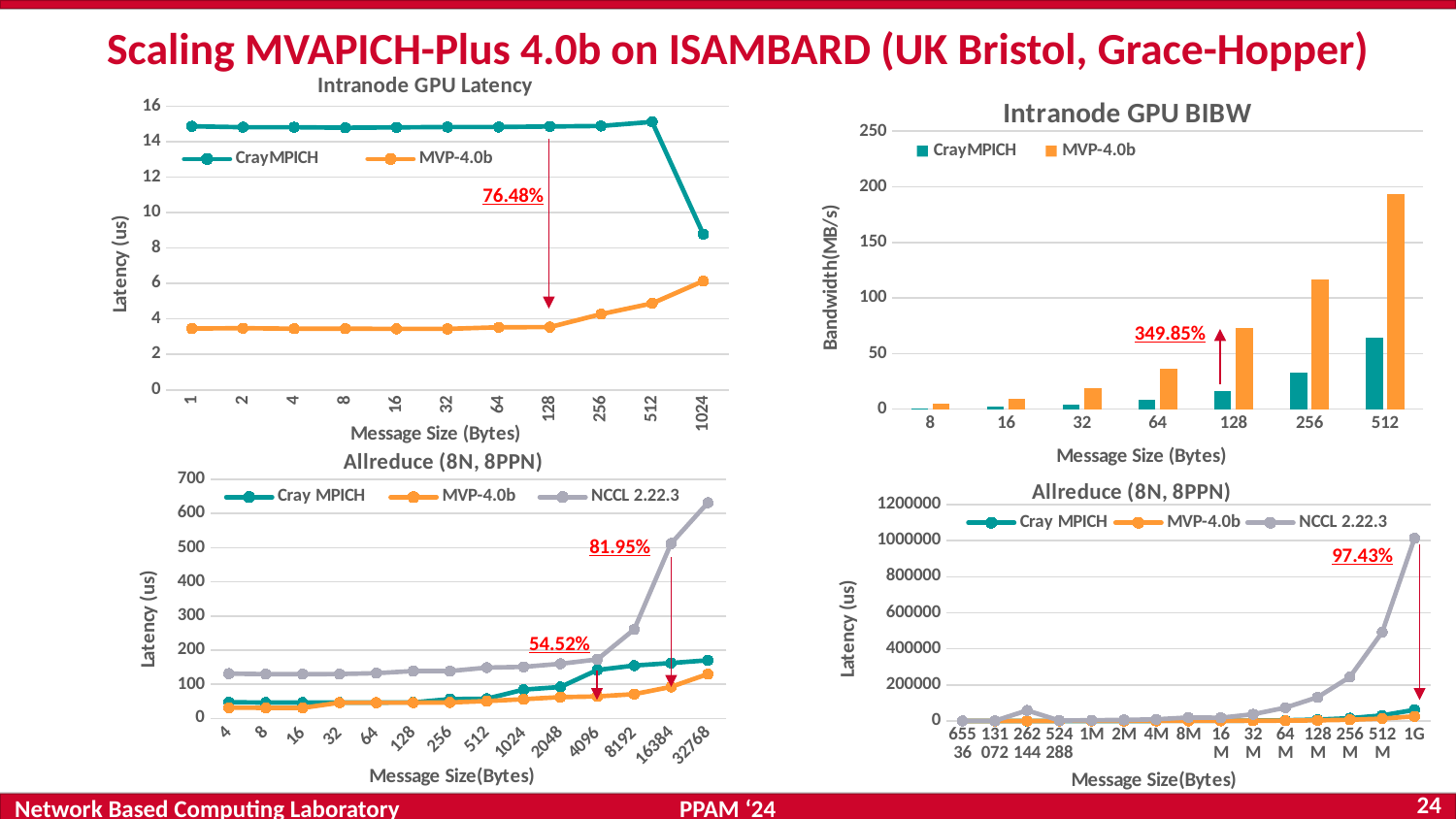
What kind of chart is the top-left 'Intranode GPU Latency' chart? line chart In the 'Intranode GPU Latency' chart, how many series does the legend list? 2 In the 'Intranode GPU Latency' chart, how many message sizes are shown on the x axis? 11 What kind of chart is the 'Intranode GPU BIBW' chart? bar chart In the 'Intranode GPU BIBW' chart, how many message sizes are shown on the x axis? 7 In the 'Intranode GPU Latency' chart, is the CrayMPICH latency at message size 1 greater or less than 10? greater In the 'Intranode GPU BIBW' chart, which series has the higher bandwidth at message size 512, CrayMPICH or MVP-4.0b? MVP-4.0b What percentage improvement is annotated on the 'Intranode GPU BIBW' chart? 349.85% In the 'Intranode GPU Latency' chart, is the MVP-4.0b latency at message size 1024 greater or less than 8? less In the 'Intranode GPU BIBW' chart, at which message size is the MVP-4.0b bandwidth highest? 512 In the bottom-right 'Allreduce (8N, 8PPN)' chart, is the NCCL 2.22.3 latency at 1G greater or less than 800000? greater In the bottom-left 'Allreduce (8N, 8PPN)' chart, how many series does the legend list? 3